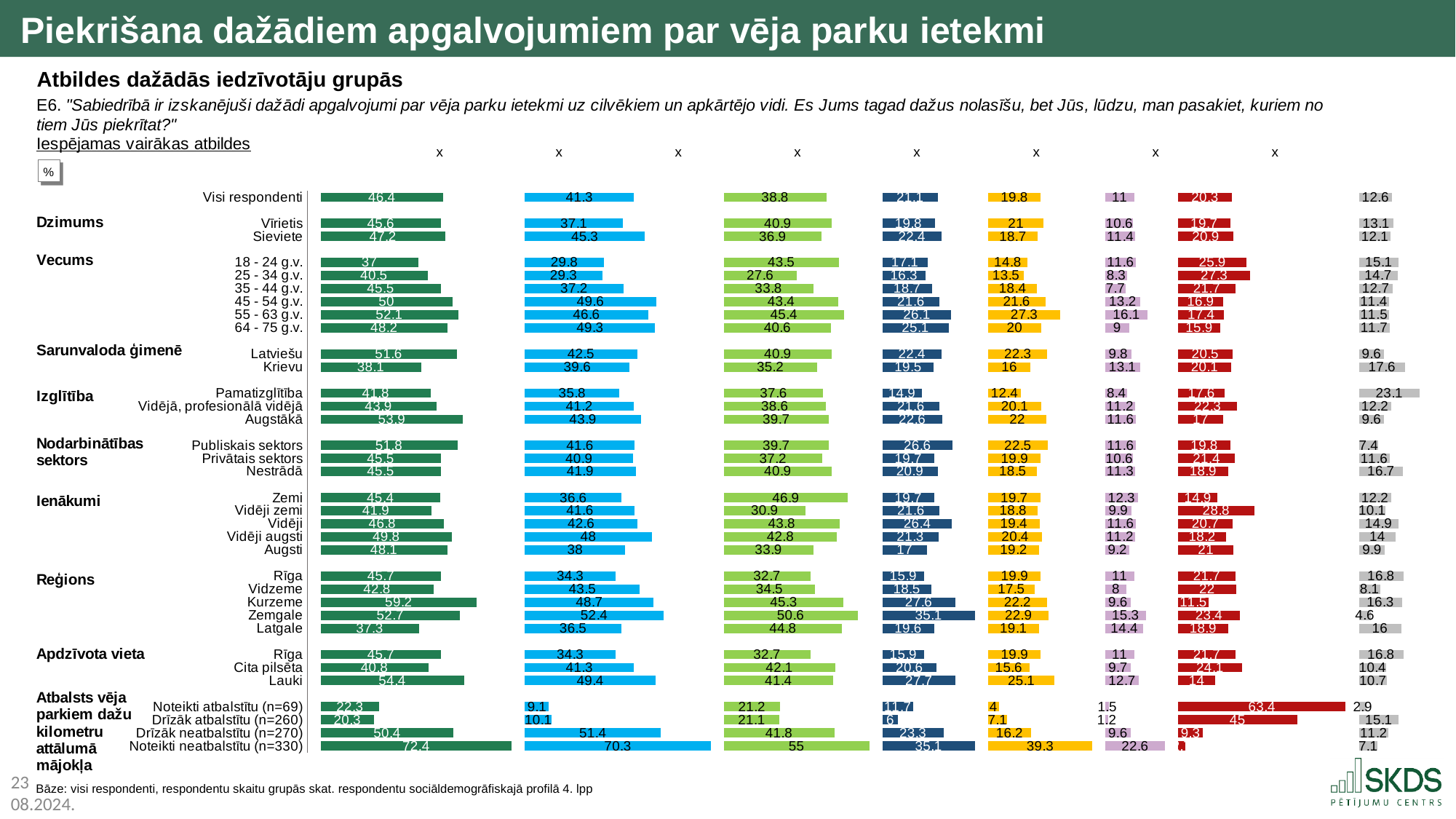
How many series (columns of bars) does the chart show? 8 Which group has the highest value in the fifth (orange) series? Noteikti neatbalstītu (n=330) What kind of chart is shown on the slide? bar chart In the first (dark green) series, what is the difference between Latviešu and Krievu? 13.5 In the second (light blue) series, what is the value for Zemgale? 52.4 In the second (light blue) series, what is the difference between Sieviete and Vīrietis? 8.2 Which group has the lowest value in the second (light blue) series? Noteikti atbalstītu (n=69) In the last (grey) series, what is the value for Latgale? 16 In the first (dark green) series, which is larger: Lauki or Rīga (Apdzīvota vieta)? Lauki In the seventh (red) series, what is the value for Noteikti atbalstītu (n=69)? 63.4 Which group has the highest value in the first (dark green) series? Noteikti neatbalstītu (n=330) In the first (dark green) series, what is the value for Visi respondenti? 46.4